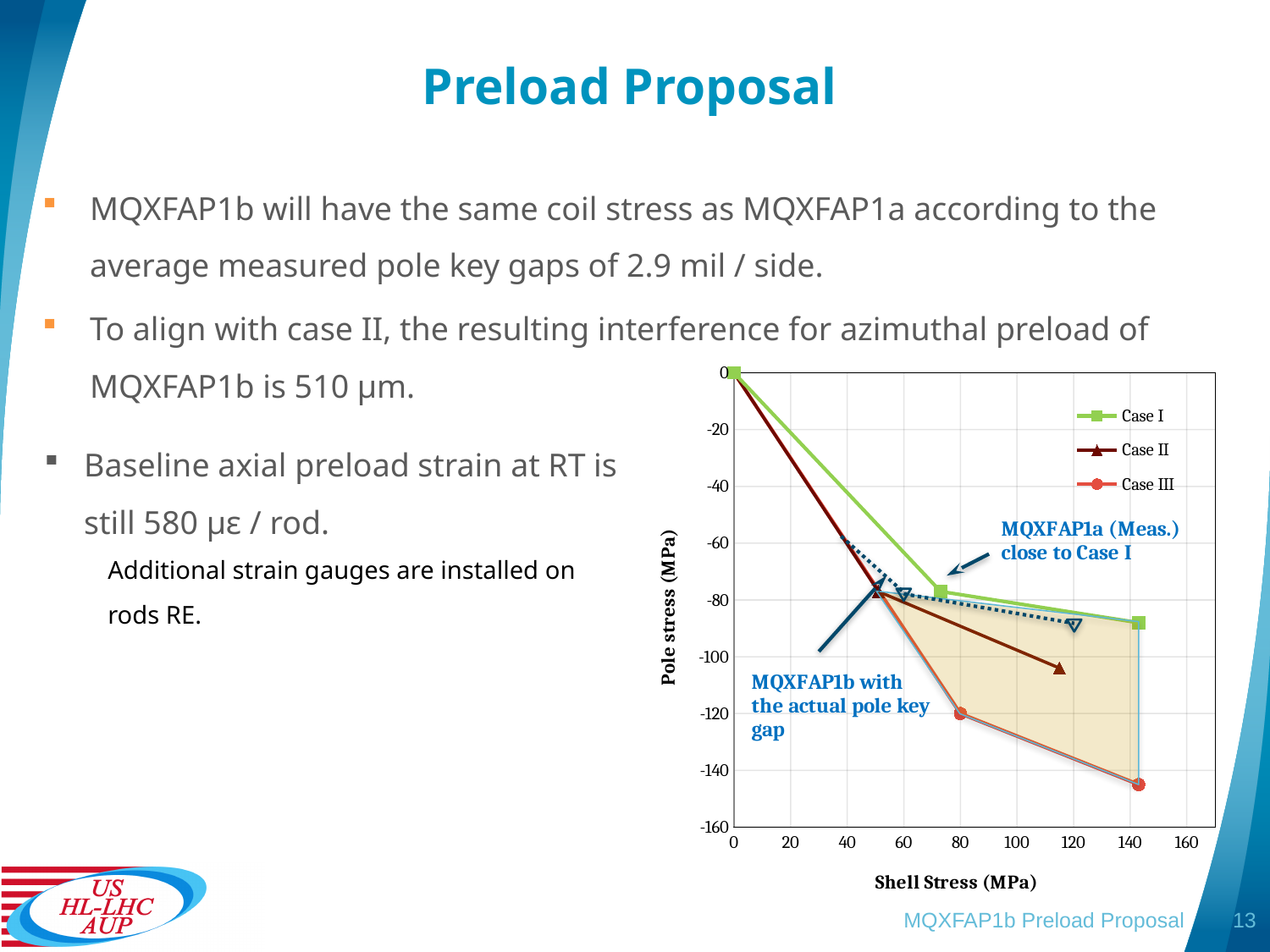
Is the pole stress for Case III at its right-most point (around 140 MPa shell stress) greater or less than -120? less What is the title of the chart's x axis? Shell Stress (MPa) As shell stress increases along the x axis, does the pole stress for Case III rise or fall? fall What kind of chart is shown on the slide? line chart Which series reaches the lowest (most negative) pole stress on the chart? Case III At a shell stress of about 140 MPa, which series has the higher (less negative) pole stress, Case I or Case III? Case I Which series does the chart annotation say the MQXFAP1a measurement is close to? Case I What are the series names listed in the chart legend? Case I, Case II, Case III Is the pole stress for Case III at a shell stress of 80 MPa greater or less than -100? less How many series does the chart legend list? 3 Is the pole stress for Case I at its right-most point (around 140 MPa shell stress) greater or less than -100? greater